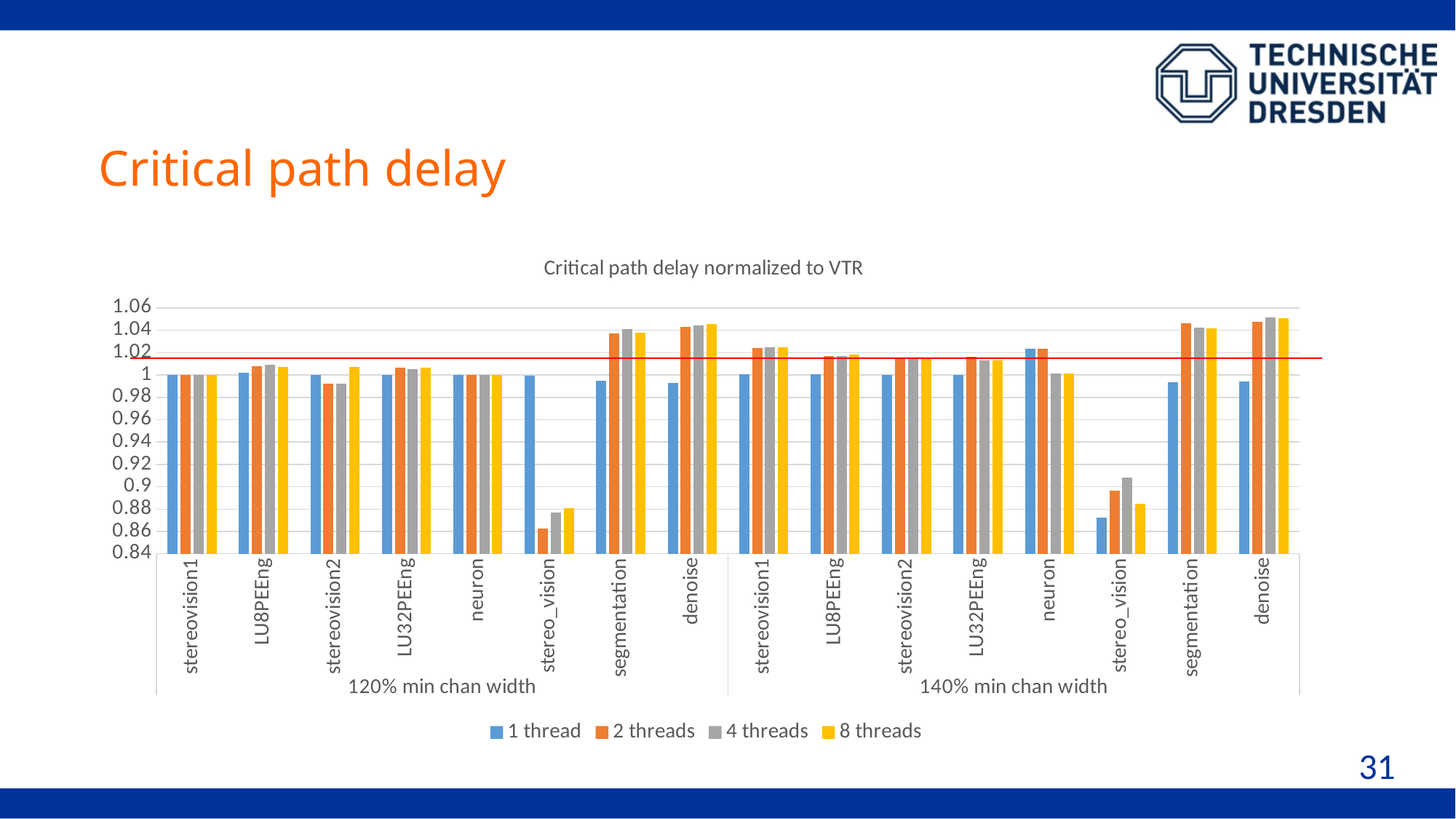
For stereo_vision with 2 threads, which group has the larger value: 120% min chan width or 140% min chan width? 140% min chan width Is the 1 thread value for segmentation in the 120% min chan width group greater or less than 1? less Which benchmark has the lowest bars in the 120% min chan width group? stereo_vision What is the title of the chart? Critical path delay normalized to VTR Which series is shown in yellow in the legend? 8 threads How many series does the legend list? 4 How many benchmark categories are shown within the 120% min chan width group? 8 Is the 8 threads value for denoise in the 120% min chan width group greater or less than 1.04? greater For neuron in the 140% min chan width group, which is larger: the 1 thread value or the 8 threads value? 1 thread Is the 2 threads value for stereo_vision in the 120% min chan width group greater or less than 0.9? less What kind of chart is shown on the slide? bar chart